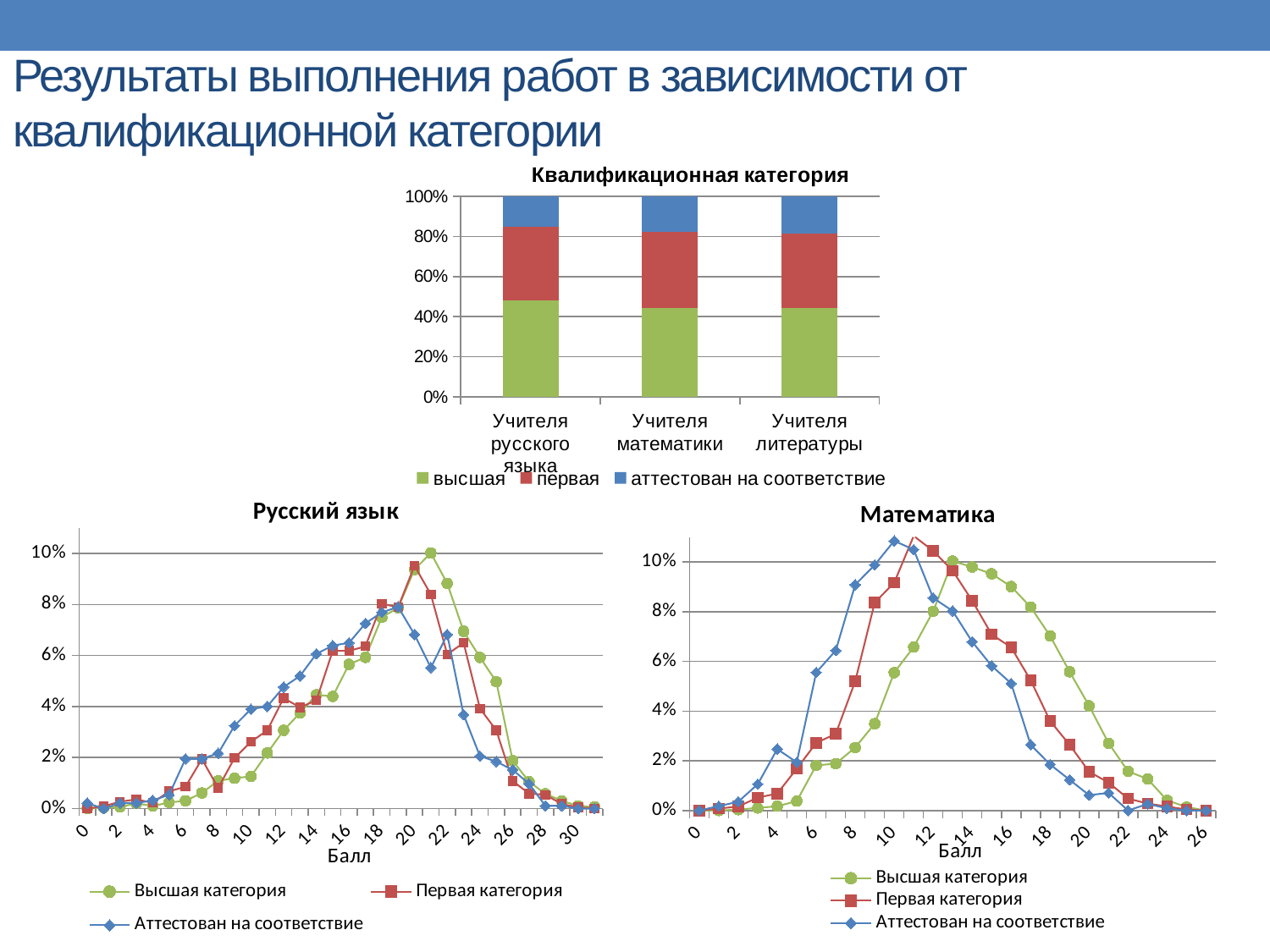
How many categories are shown on the x axis of the "Квалификационная категория" chart? 3 How many series does the legend of the "Русский язык" chart list? 3 In the "Русский язык" chart, is the value for Высшая категория at score 21 greater or less than 8%? greater In the "Квалификационная категория" chart, which series has the largest share for Учителя математики? высшая In the "Квалификационная категория" chart, is the "высшая" share for Учителя русского языка greater or less than 40%? greater In the "Математика" chart, at score 8, which is larger: Аттестован на соответствие or Высшая категория? Аттестован на соответствие How many series does the legend of the "Квалификационная категория" chart list? 3 In the "Математика" chart, does the Высшая категория series rise or fall from score 16 to score 26? fall In the "Математика" chart, is the highest value of the Аттестован на соответствие series greater or less than 10%? greater What kind of chart is the "Квалификационная категория" chart? stacked bar chart What kind of chart is the "Русский язык" chart? line chart What is the x-axis title of the "Русский язык" chart? Балл